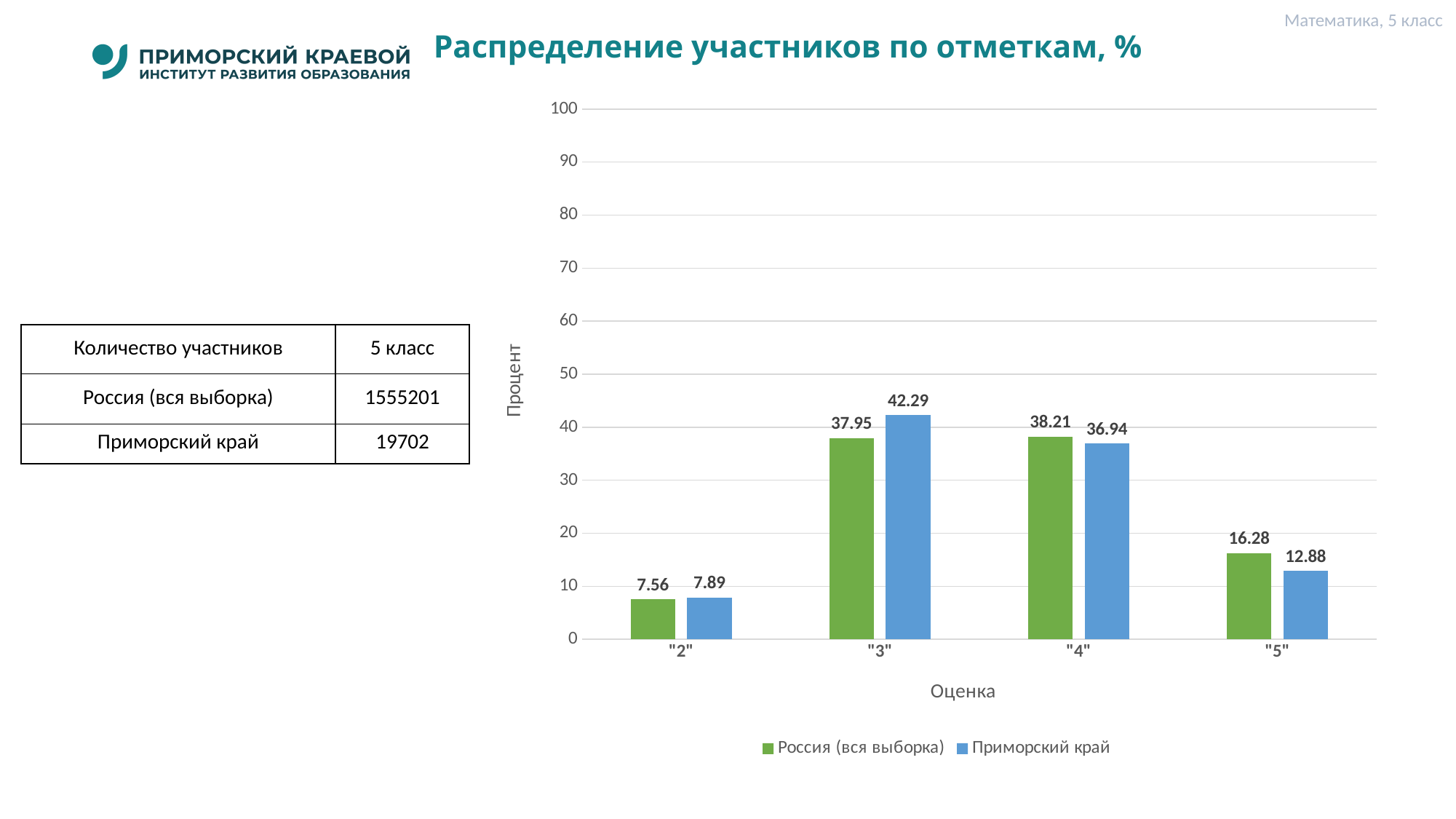
Is the value for Приморский край at grade "4" greater or less than 30? greater What is the value for Приморский край at grade "5"? 12.88 What is the title of the chart? Распределение участников по отметкам, % What is the value for Приморский край at grade "3"? 42.29 How many series does the legend list? 2 Which grade has the lowest value for Россия (вся выборка)? "2" Which grade has the highest value for Приморский край? "3" How many grade categories are shown on the x axis? 4 At grade "5", which series has the larger value: Россия (вся выборка) or Приморский край? Россия (вся выборка) What is the value for Россия (вся выборка) at grade "4"? 38.21 What is the difference between Приморский край and Россия (вся выборка) at grade "3"? 4.34 What kind of chart is shown on the slide? bar chart